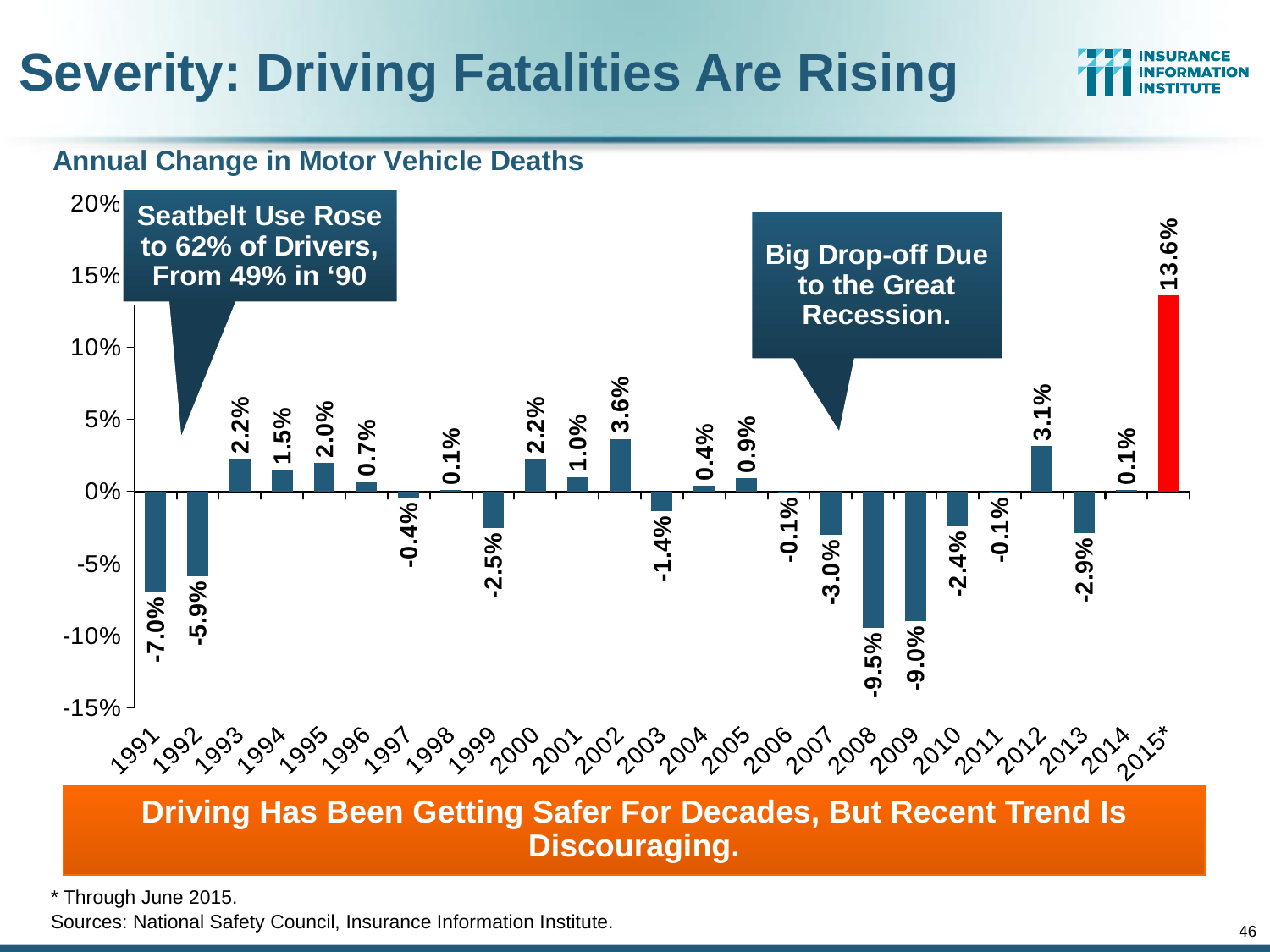
How many years are shown on the x axis of the chart? 25 What is the difference between the annual change in 2008 and the annual change in 2009? 0.5 percentage points What is the difference between the annual change in 2015* and the annual change in 2012? 10.5 percentage points Which year had a larger annual change in motor vehicle deaths, 2012 or 2002? 2002 What is the annual change in motor vehicle deaths shown for 1991? -7.0% Which year has the highest annual change in motor vehicle deaths? 2015* Which year has the lowest annual change in motor vehicle deaths? 2008 What kind of chart is used to show the annual change in motor vehicle deaths? Bar chart What is the annual change in motor vehicle deaths shown for 2015*? 13.6% Which bar in the chart is coloured red rather than dark blue? 2015* What is the annual change in motor vehicle deaths shown for 2008? -9.5% What is the annual change in motor vehicle deaths shown for 2002? 3.6%